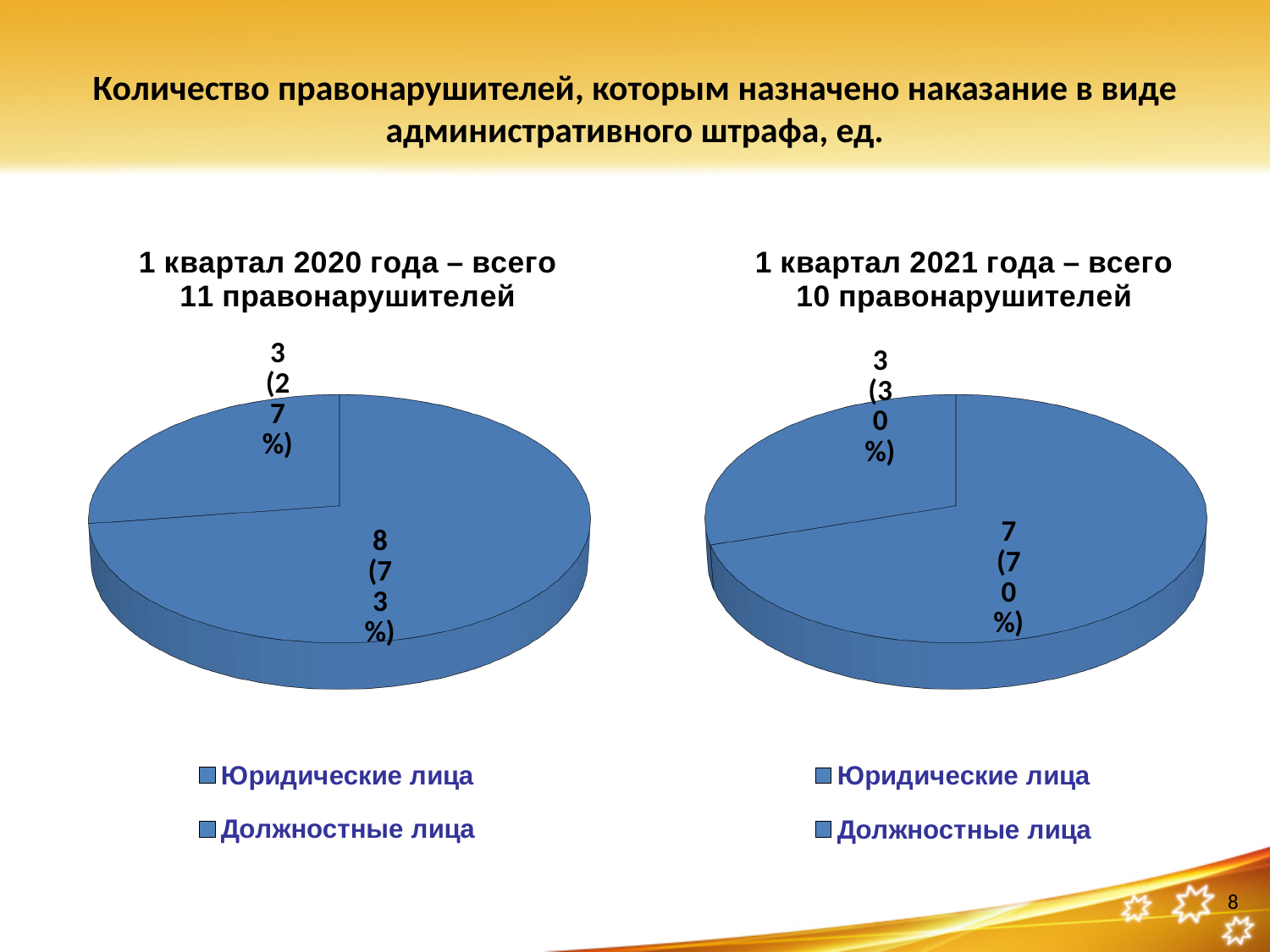
According to the chart titles, what is the total number of offenders in 1 квартал 2020 года? 11 In the left chart (1 квартал 2020 года), what share of the pie does the larger slice take? 73% What kind of chart is used on the left (1 квартал 2020 года)? pie chart In the right chart (1 квартал 2021 года), what is the value of the smaller slice? 3 (30%) How many slices does the right chart (1 квартал 2021 года) have? 2 What two entries does the legend of the left chart list? Юридические лица, Должностные лица In the right chart (1 квартал 2021 года), what is the difference between the larger and smaller slice values? 4 In the right chart (1 квартал 2021 года), what is the value of the larger slice? 7 (70%) In the left chart (1 квартал 2020 года), what is the difference between the larger and smaller slice values? 5 In the left chart (1 квартал 2020 года), what is the value of the larger slice? 8 (73%) In the right chart (1 квартал 2021 года), what share of the pie does the smaller slice take? 30% In the left chart (1 квартал 2020 года), what is the value of the smaller slice? 3 (27%)